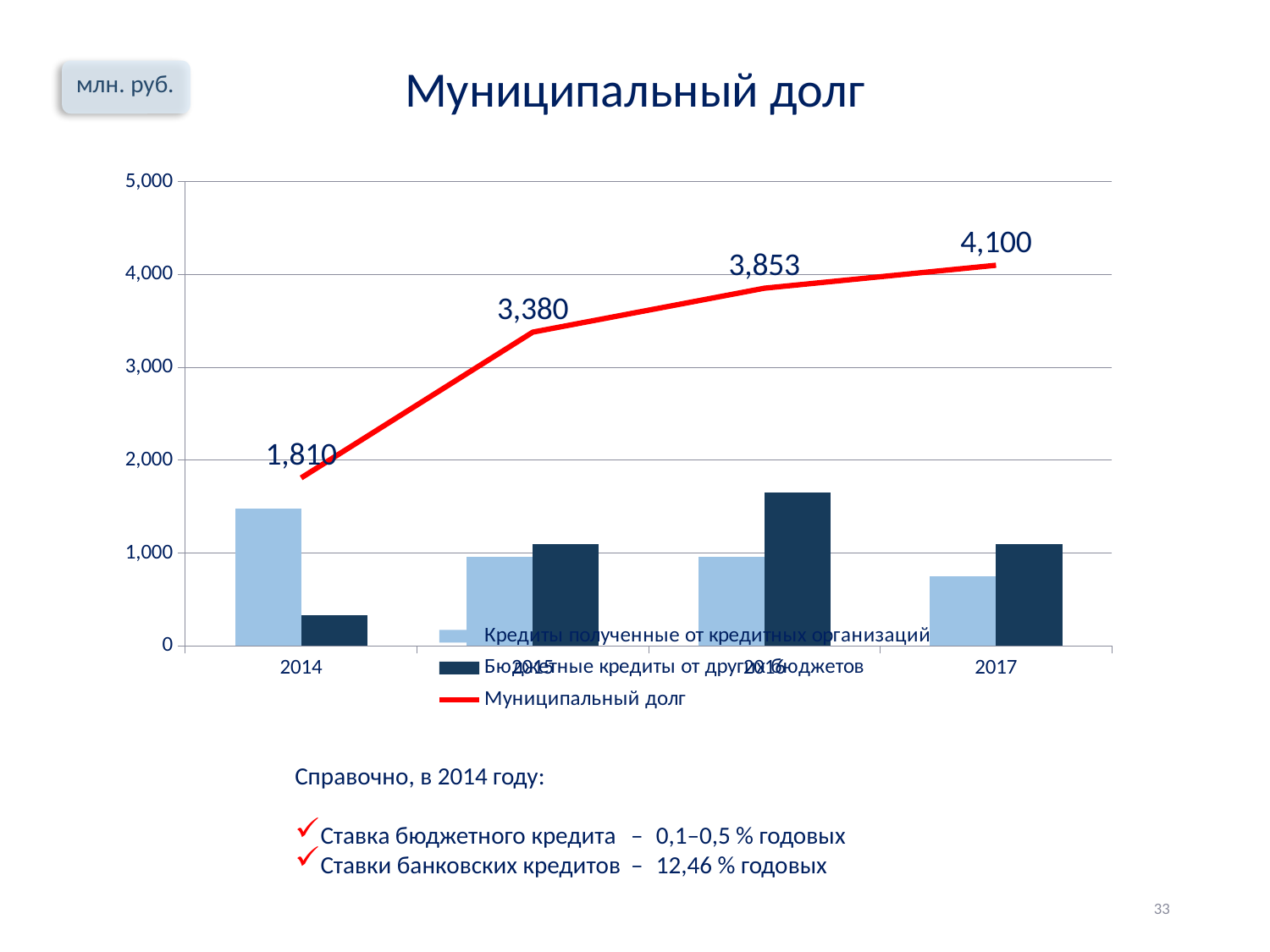
What is the title of the chart? Муниципальный долг In which year is Муниципальный долг the highest? 2017 What is the value of Муниципальный долг in 2014? 1,810 Is the value for Бюджетные кредиты от других бюджетов in 2016 greater or less than 1,000? greater Is the value for Бюджетные кредиты от других бюджетов in 2014 greater or less than 1,000? less What is the value of Муниципальный долг in 2017? 4,100 What is the difference in Муниципальный долг between 2016 and 2015? 473 How many series does the legend list? 3 In which year is Муниципальный долг the lowest? 2014 Does Муниципальный долг rise or fall from 2014 to 2017? rise Is the value for Кредиты полученные от кредитных организаций in 2014 greater or less than 1,000? greater What is the value of Муниципальный долг in 2015? 3,380